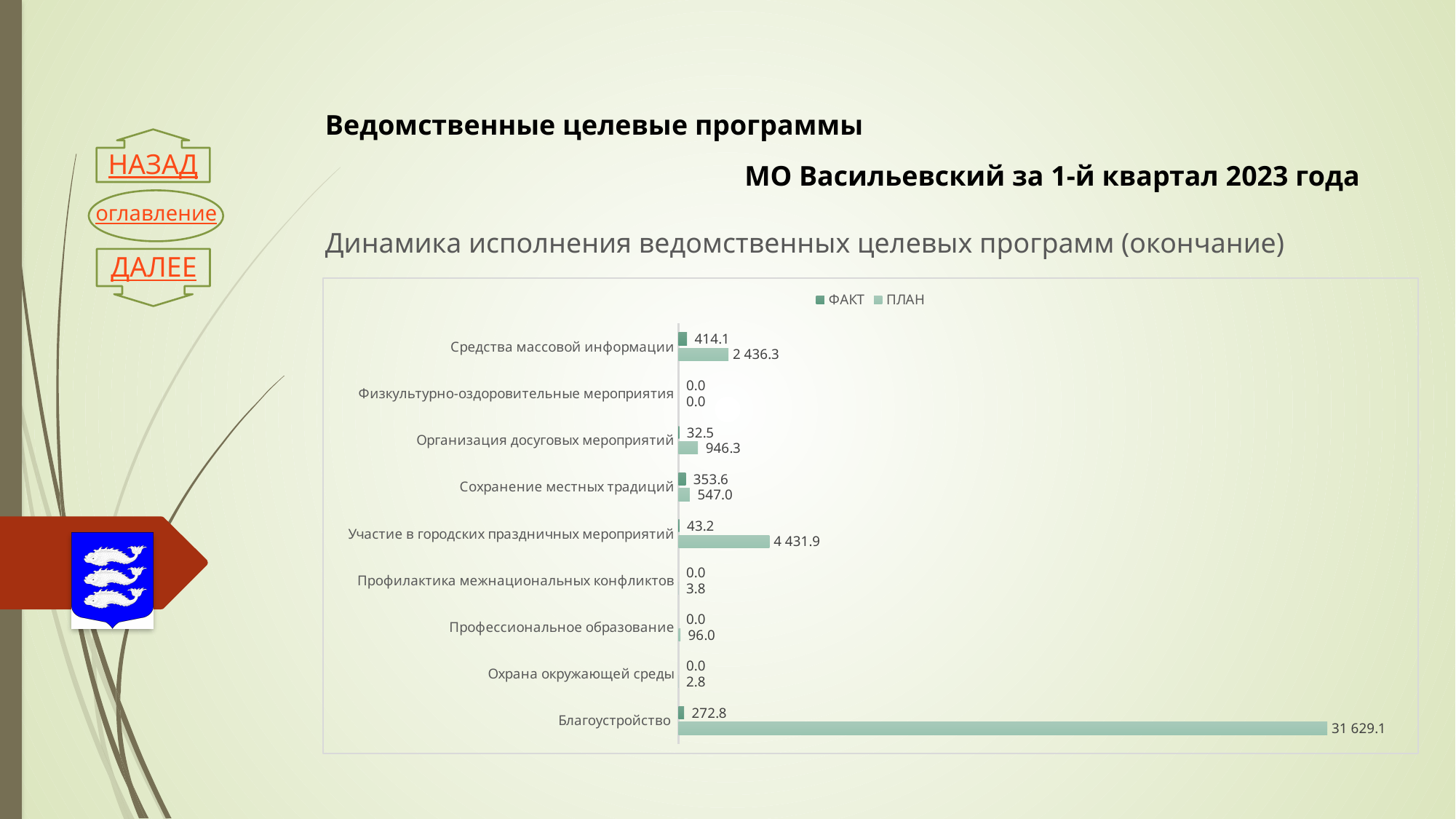
What is the ФАКТ value for Сохранение местных традиций? 353.6 What is the ПЛАН value for Участие в городских праздничных мероприятий? 4 431.9 What is the ПЛАН value for Благоустройство? 31 629.1 How many categories are shown on the chart? 9 What are the two series named in the legend? ФАКТ and ПЛАН What is the difference between the ПЛАН and ФАКТ values for Сохранение местных традиций? 193.4 What type of chart is shown on the slide? bar chart Which is larger for Организация досуговых мероприятий, the ФАКТ value or the ПЛАН value? ПЛАН What is the ФАКТ value for Средства массовой информации? 414.1 How many series does the legend list? 2 Which category has the highest ПЛАН value? Благоустройство Which category has the highest ФАКТ value? Средства массовой информации